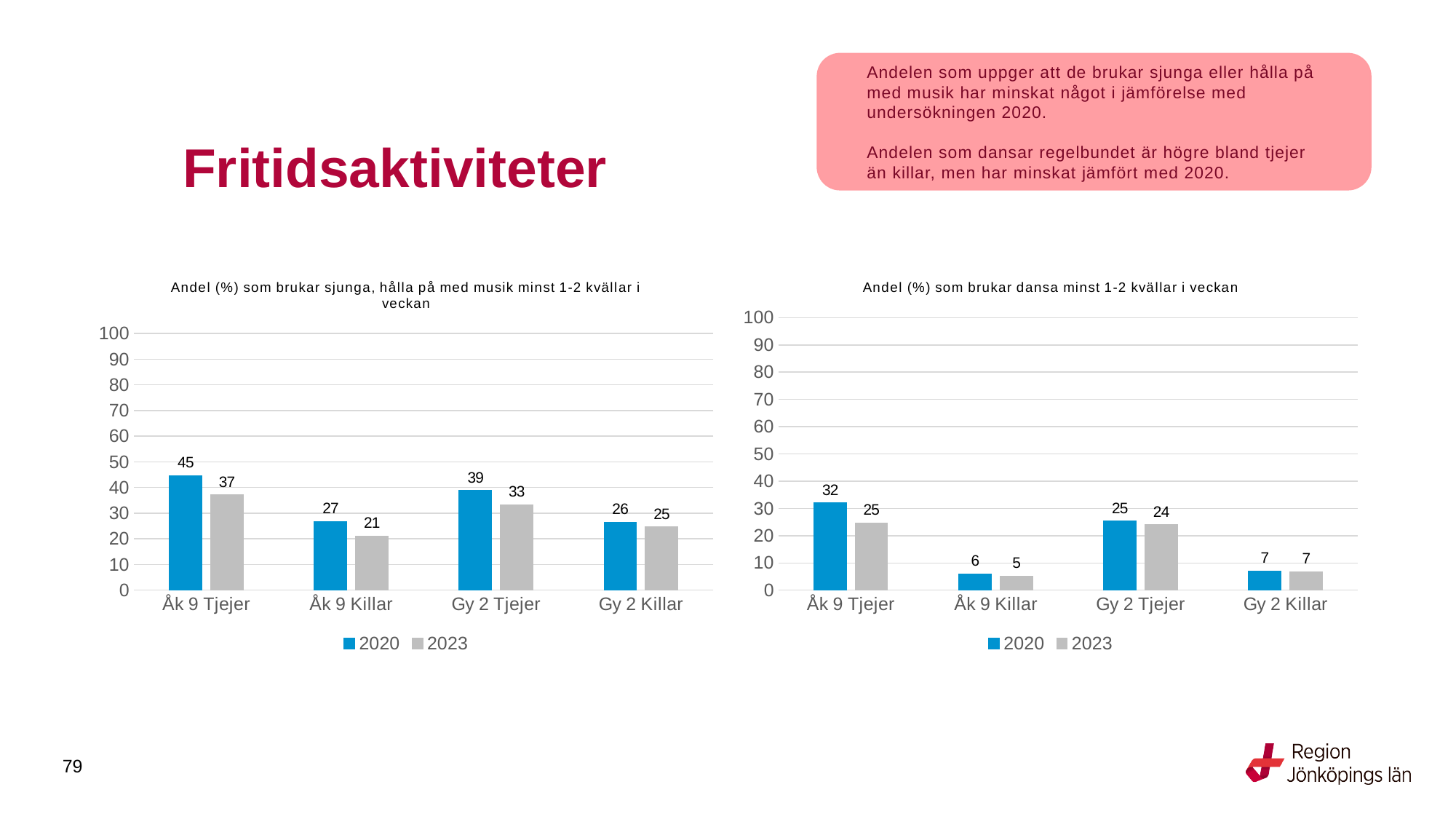
In the right chart (dansa), which category has the highest 2020 value? Åk 9 Tjejer In the left chart (Andel (%) som brukar sjunga, hålla på med musik minst 1-2 kvällar i veckan), what is the value for Åk 9 Tjejer in 2020? 45 In the right chart (dansa), what is the 2023 value for Gy 2 Killar? 7 What kind of chart is the right chart (dansa)? Bar chart How many categories are shown on the x axis of the right chart (dansa)? 4 In the right chart (dansa), what is the difference between the 2020 values for Åk 9 Tjejer and Gy 2 Tjejer? 7 How many series does the legend of the left chart (sjunga, hålla på med musik) list? 2 In the right chart (Andel (%) som brukar dansa minst 1-2 kvällar i veckan), what is the 2020 value for Åk 9 Killar? 6 In the right chart (dansa), which category has the lowest 2023 value? Åk 9 Killar In the left chart (sjunga, hålla på med musik), what is the difference between the 2020 and 2023 values for Åk 9 Tjejer? 8 In the left chart (sjunga, hålla på med musik), what is the 2023 value for Gy 2 Killar? 25 In the left chart (sjunga, hålla på med musik), which is larger: the 2023 value for Åk 9 Tjejer or the 2023 value for Gy 2 Tjejer? Åk 9 Tjejer